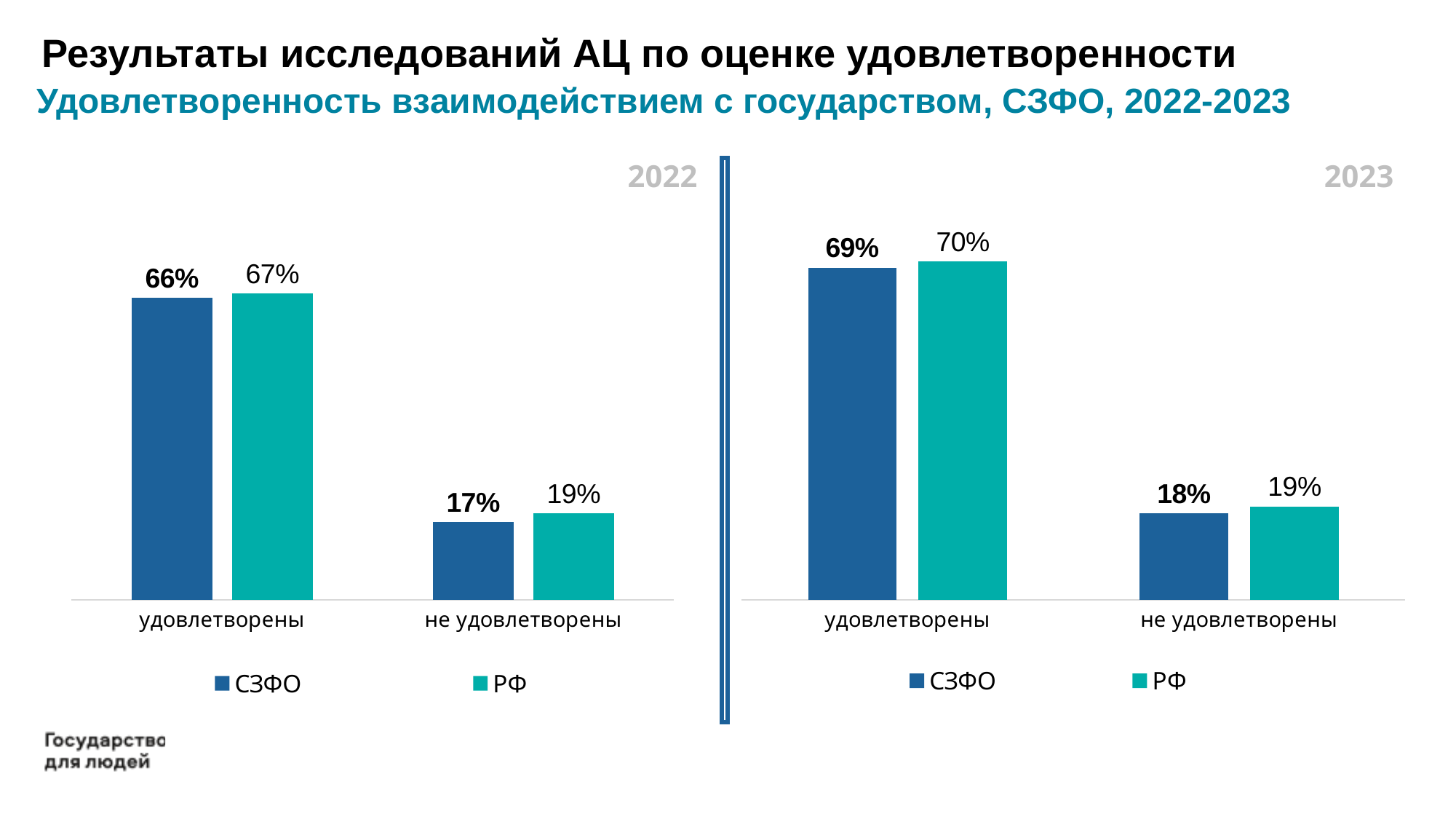
In the 2022 chart, what is the difference between the РФ and СЗФО values for 'не удовлетворены'? 2% In the 2022 chart, which category has the lowest value for СЗФО? не удовлетворены In the 2023 chart, which category has the highest value for РФ? удовлетворены In the 2023 chart, what is the value for СЗФО in the 'не удовлетворены' category? 18% In the 2022 chart, what is the value for РФ in the 'не удовлетворены' category? 19% How many series does the legend of the 2022 chart list? 2 In the 2023 chart, what is the value for РФ in the 'удовлетворены' category? 70% How many categories are shown on the x axis of the 2023 chart? 2 In the 2022 chart, what is the value for СЗФО in the 'удовлетворены' category? 66% What kind of chart is the 2022 chart? bar chart In the 2023 chart, what is the difference between the СЗФО values for 'удовлетворены' and 'не удовлетворены'? 51% In the 2023 chart, which is larger for 'удовлетворены': СЗФО or РФ? РФ